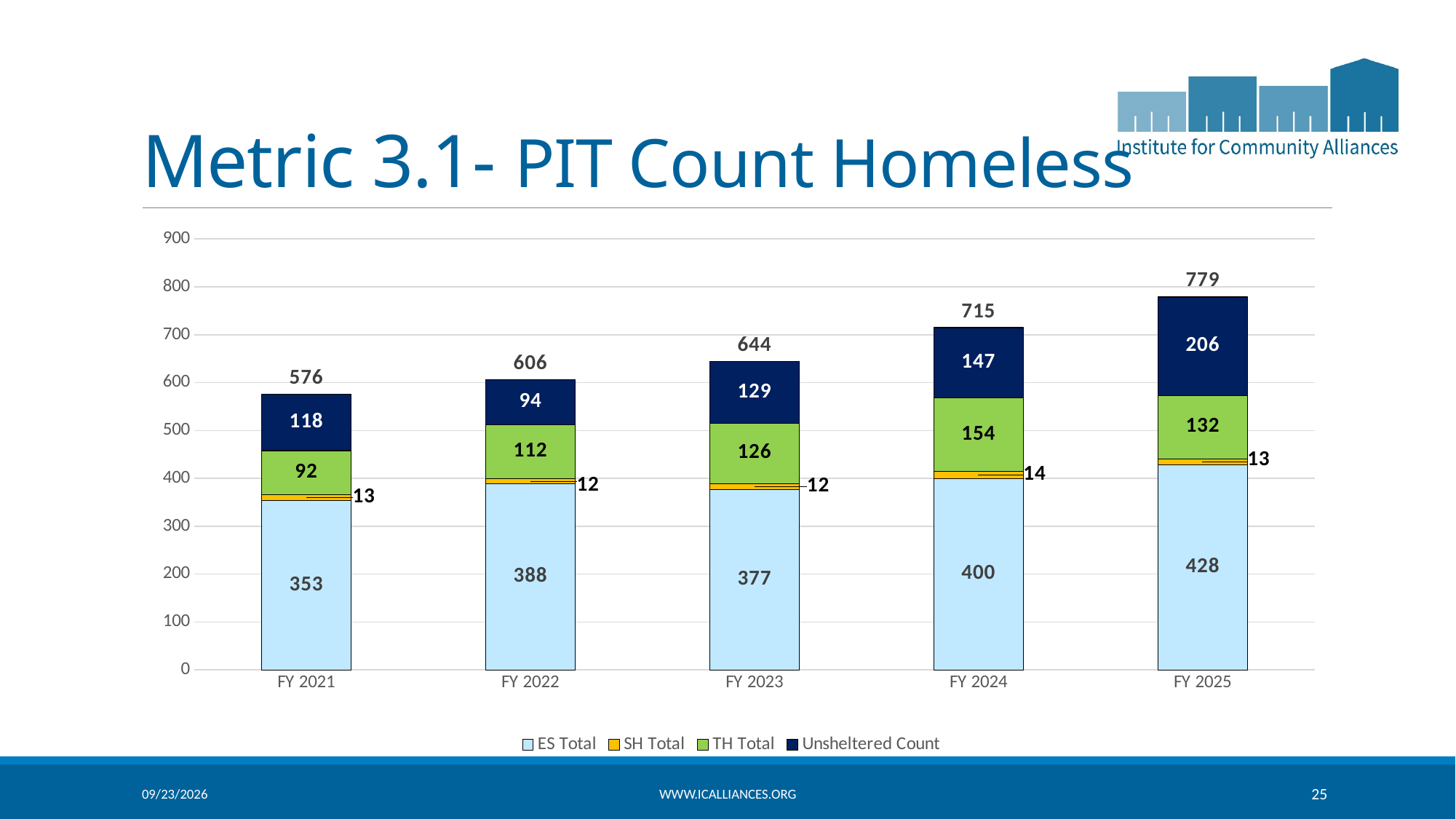
What is the ES Total value for FY 2023? 377 What is the difference between the total for FY 2025 and the total for FY 2021? 203 What is the total of the stacked bar for FY 2024? 715 Which is larger, the TH Total for FY 2022 or the TH Total for FY 2023? FY 2023 Which fiscal year has the highest total PIT count? FY 2025 How many fiscal years are shown on the x axis? 5 How many series does the legend list? 4 Which fiscal year has the lowest Unsheltered Count? FY 2022 What is the TH Total value for FY 2024? 154 Do the total PIT counts rise or fall from FY 2021 to FY 2025? rise What is the SH Total value for FY 2021? 13 What is the Unsheltered Count for FY 2025? 206